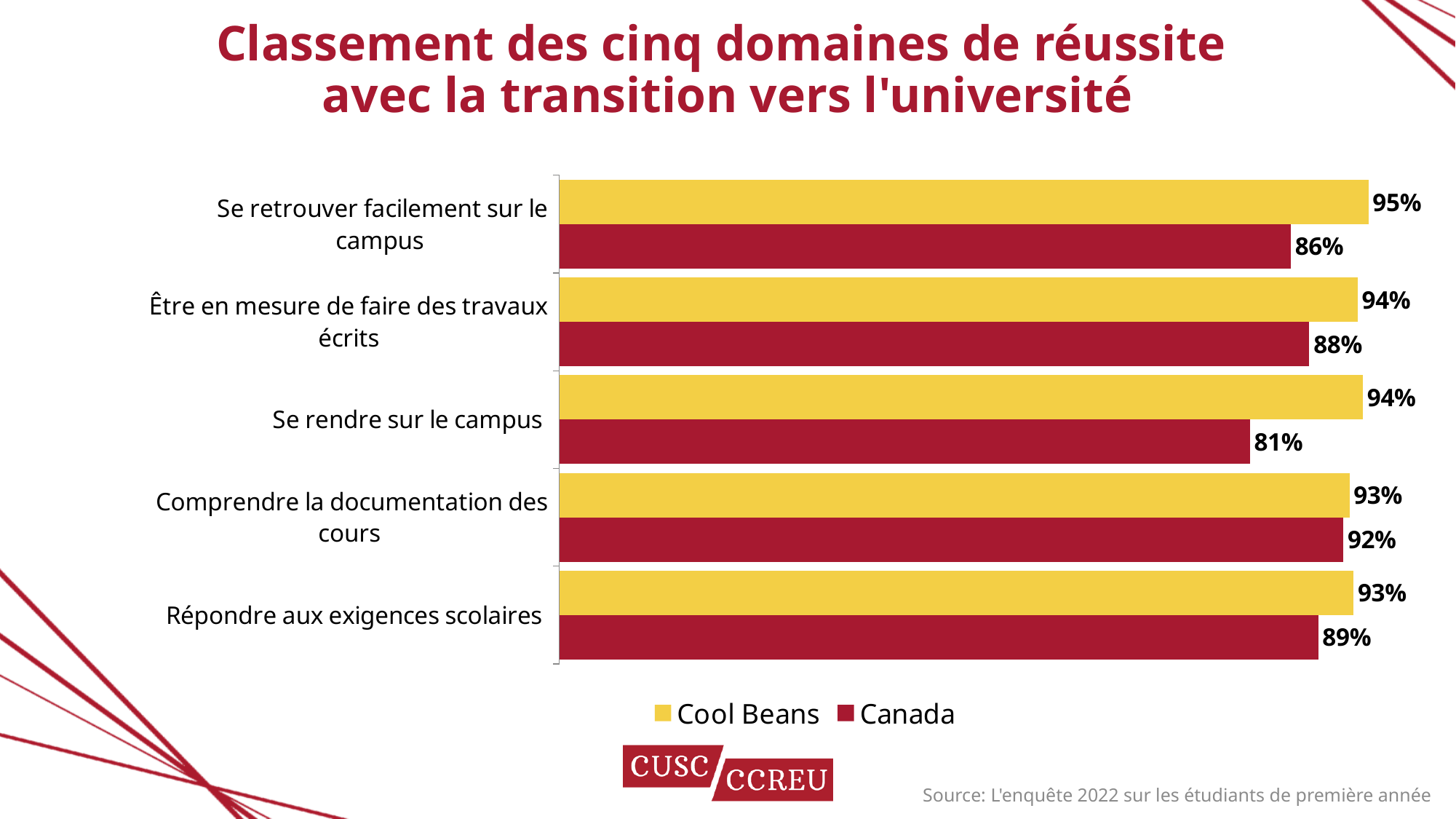
Which category has the highest Cool Beans value? Se retrouver facilement sur le campus How many series does the legend list? 2 What is the Cool Beans value for "Se retrouver facilement sur le campus"? 95% What is the difference between the Cool Beans and Canada values for "Être en mesure de faire des travaux écrits"? 6% What is the difference between the Cool Beans and Canada values for "Se rendre sur le campus"? 13% How many categories are shown on the chart? 5 What kind of chart is shown on the slide? Bar chart What is the Cool Beans value for "Répondre aux exigences scolaires"? 93% What is the Canada value for "Comprendre la documentation des cours"? 92% Which is larger for "Répondre aux exigences scolaires": the Cool Beans value or the Canada value? Cool Beans What is the Canada value for "Se rendre sur le campus"? 81% Which category has the lowest Canada value? Se rendre sur le campus